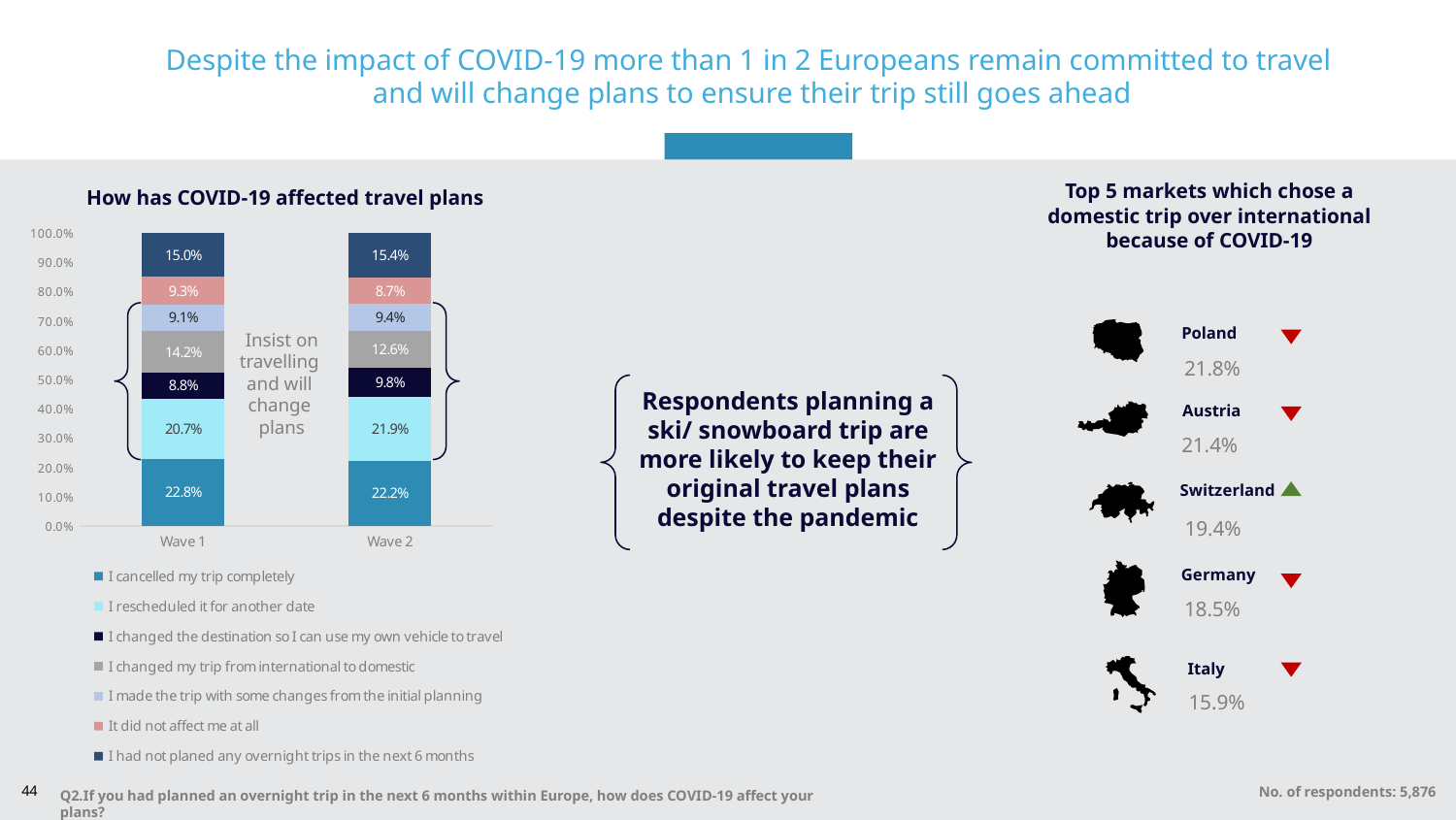
In the 'How has COVID-19 affected travel plans' chart, what is the value for 'I rescheduled it for another date' in Wave 2? 21.9% In the 'How has COVID-19 affected travel plans' chart, what is the value for 'I changed my trip from international to domestic' in Wave 1? 14.2% In the 'How has COVID-19 affected travel plans' chart, which segment is the smallest in the Wave 2 bar? It did not affect me at all In the 'How has COVID-19 affected travel plans' chart, what is the value for 'I had not planed any overnight trips in the next 6 months' in Wave 2? 15.4% In the 'How has COVID-19 affected travel plans' chart, which wave has the larger value for 'I rescheduled it for another date'? Wave 2 In the 'Top 5 markets which chose a domestic trip over international because of COVID-19' panel, what is the value for Poland? 21.8% In the 'How has COVID-19 affected travel plans' chart, what is the difference between the 'I cancelled my trip completely' values for Wave 1 and Wave 2? 0.6 percentage points What kind of chart is 'How has COVID-19 affected travel plans'? Stacked bar chart In the 'How has COVID-19 affected travel plans' chart, how many categories are shown on the x axis? 2 In the 'How has COVID-19 affected travel plans' chart, what is the value for 'I cancelled my trip completely' in Wave 1? 22.8% In the 'How has COVID-19 affected travel plans' chart, which segment is the largest in the Wave 2 bar? I cancelled my trip completely How many series does the legend of the 'How has COVID-19 affected travel plans' chart list? 7